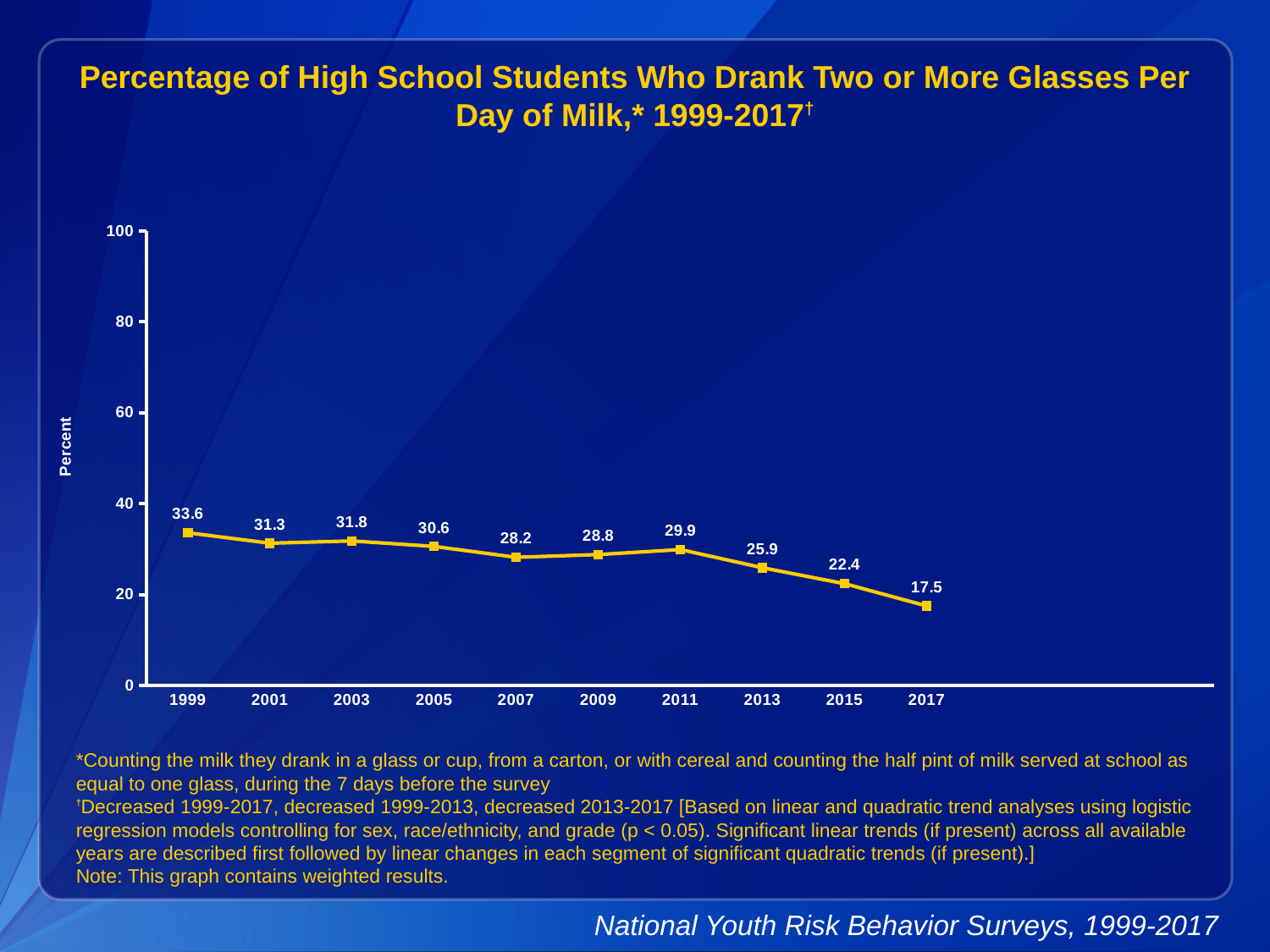
Which year has the highest value on the chart? 1999 Is the value for 2013 greater or less than 20? greater What is the value plotted for 2017? 17.5 What is the difference between the 1999 value and the 2017 value? 16.1 What is the label on the y axis? Percent Do the values generally rise or fall from 1999 to 2017? Fall Which year has the lowest value on the chart? 2017 What percentage of high school students drank two or more glasses of milk per day in 1999? 33.6 What kind of chart is shown on the slide? Line chart What is the value plotted for 2011? 29.9 Which year has the larger value, 2003 or 2005? 2003 How many years are plotted on the x axis? 10